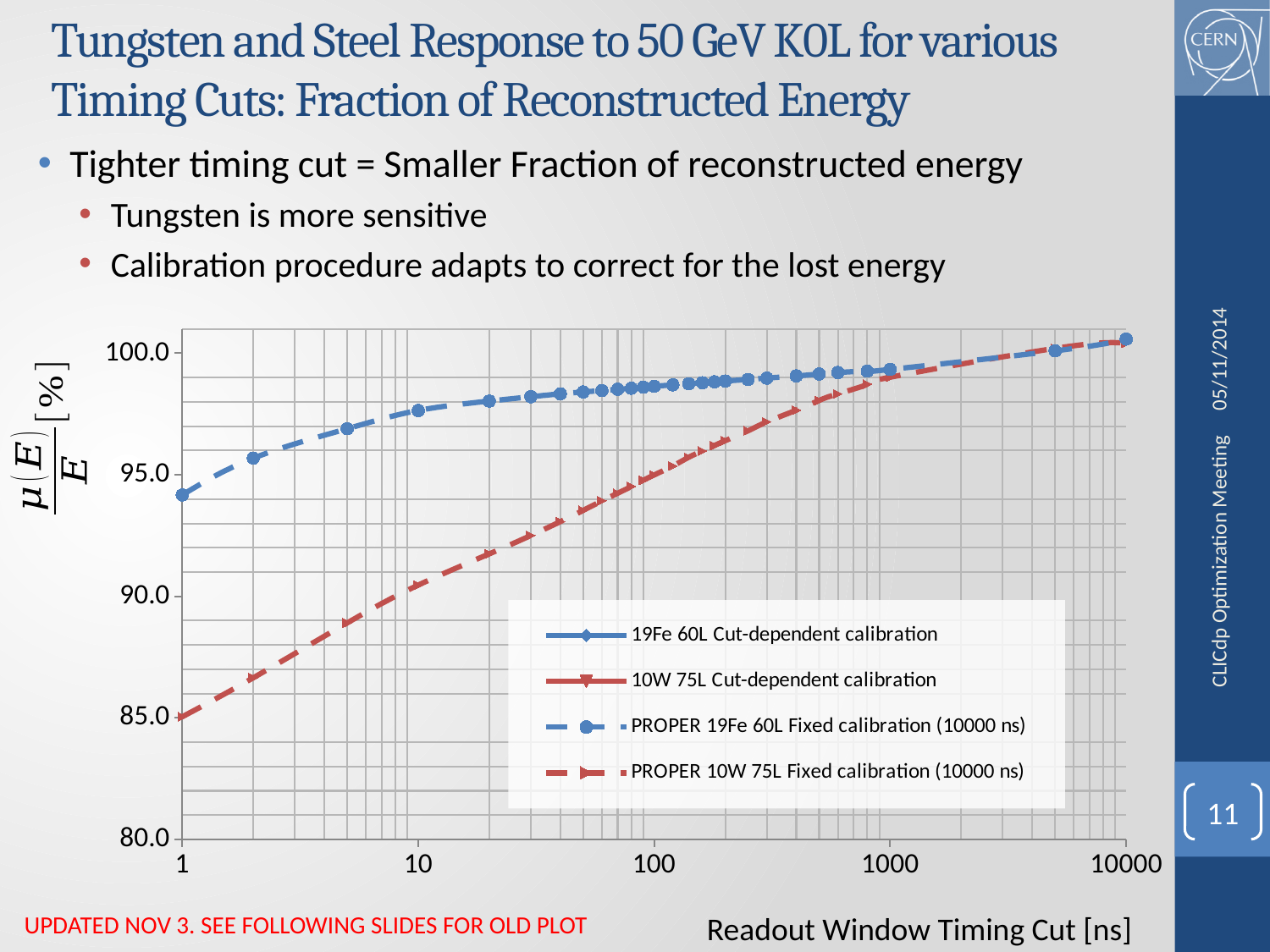
Is the value of the red (10W 75L) series at a timing cut of 1000 ns greater or less than 95.0? greater How many series does the legend list? 4 What kind of chart is shown on the slide? line chart Is the value of the blue (19Fe 60L) series at a timing cut of 10 ns greater or less than 95.0? greater At a timing cut of 10 ns, which series has the higher value, the blue (19Fe 60L) or the red (10W 75L)? blue (19Fe 60L) Is the value of the red (10W 75L) series at a timing cut of 1 ns greater or less than 90.0? less What is the label of the x axis? Readout Window Timing Cut [ns] What is the largest tick value shown on the x axis? 10000 Do the plotted values rise or fall as the readout window timing cut increases along the x axis? rise